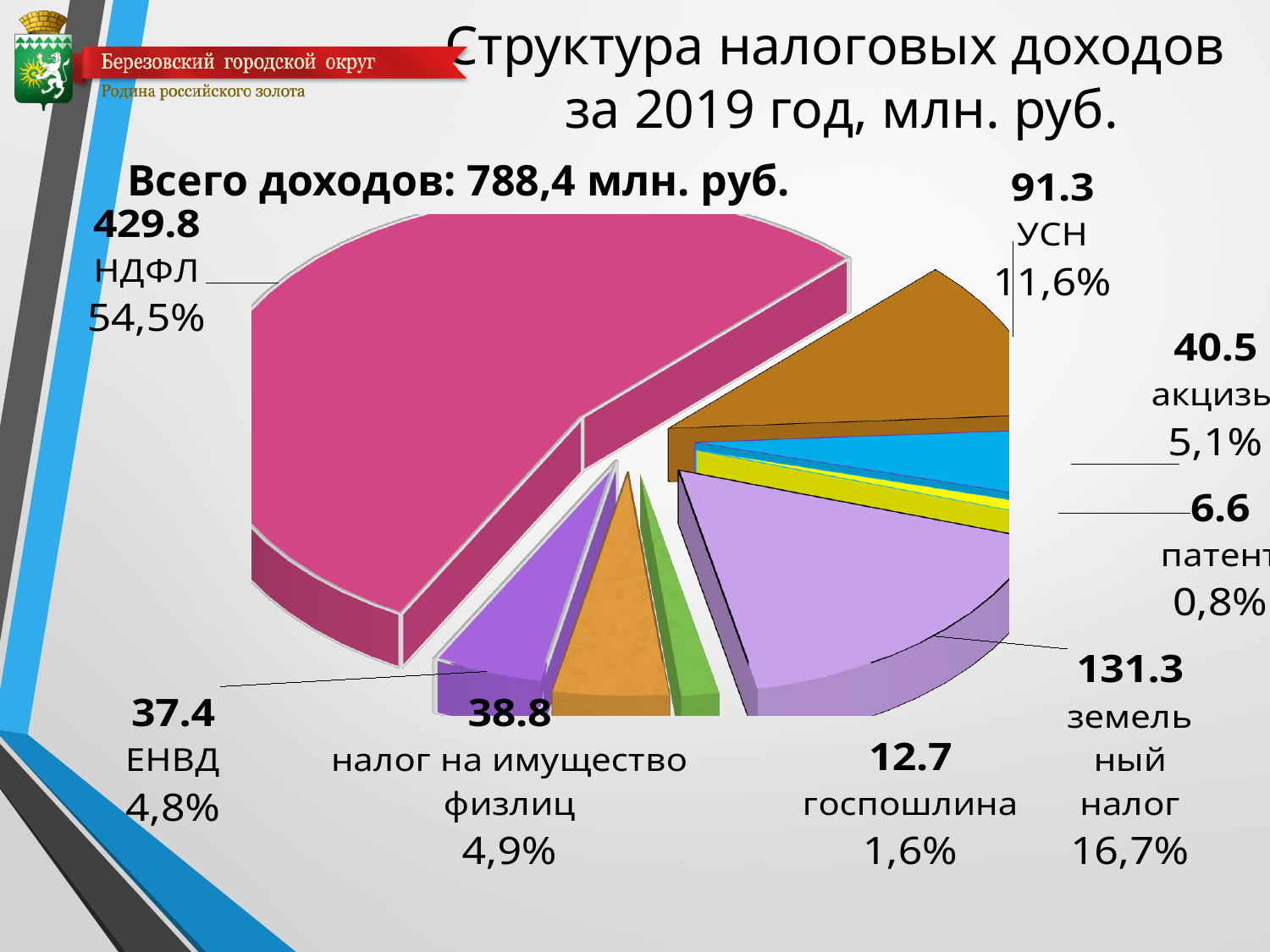
What is the value for земельный налог? 131.3 What share of the pie does НДФЛ take? 54,5% What is the value for УСН? 91.3 How many slices does the pie chart have? 8 What share of the pie does госпошлина take? 1,6% Which category has the largest slice? НДФЛ What is the value for патент? 6.6 Which is larger, the value for акцизы or the value for ЕНВД? акцизы What kind of chart is shown on the slide? pie chart Which category has the smallest slice? патент What is the value for НДФЛ? 429.8 What is the difference between the values for земельный налог and УСН? 40.0